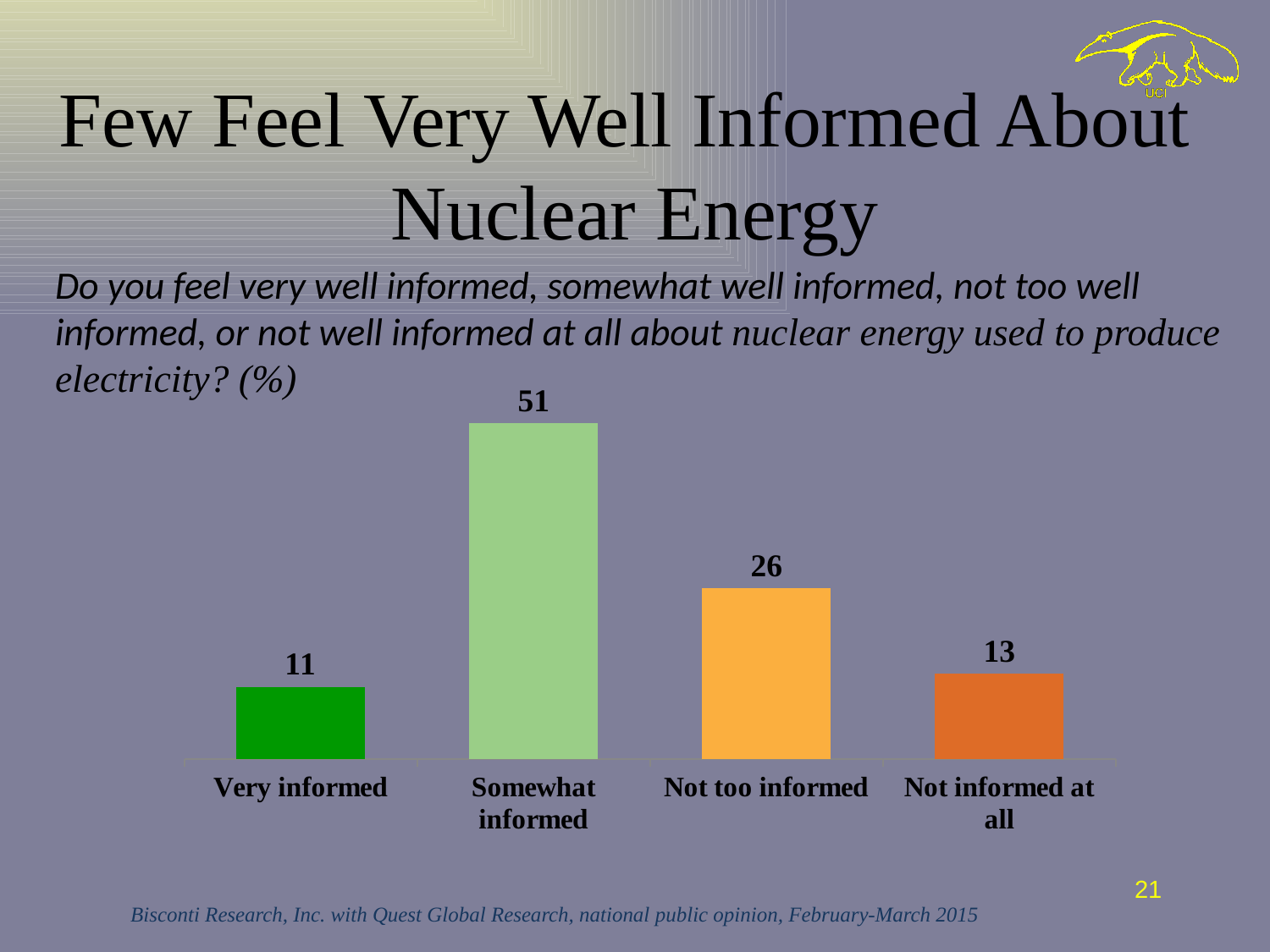
What is the difference between the values for "Not informed at all" and "Very informed"? 2 What is the value for "Very informed"? 11 What kind of chart is shown on the slide? Bar chart Which category has the lowest value? Very informed What is the value for "Somewhat informed"? 51 What is the value for "Not too informed"? 26 Which is larger, the value for "Not too informed" or the value for "Not informed at all"? Not too informed Which category has the highest value? Somewhat informed What is the value for "Not informed at all"? 13 What colour is the bar for "Not informed at all"? Orange What is the difference between the values for "Somewhat informed" and "Not too informed"? 25 How many categories are shown in the chart? 4